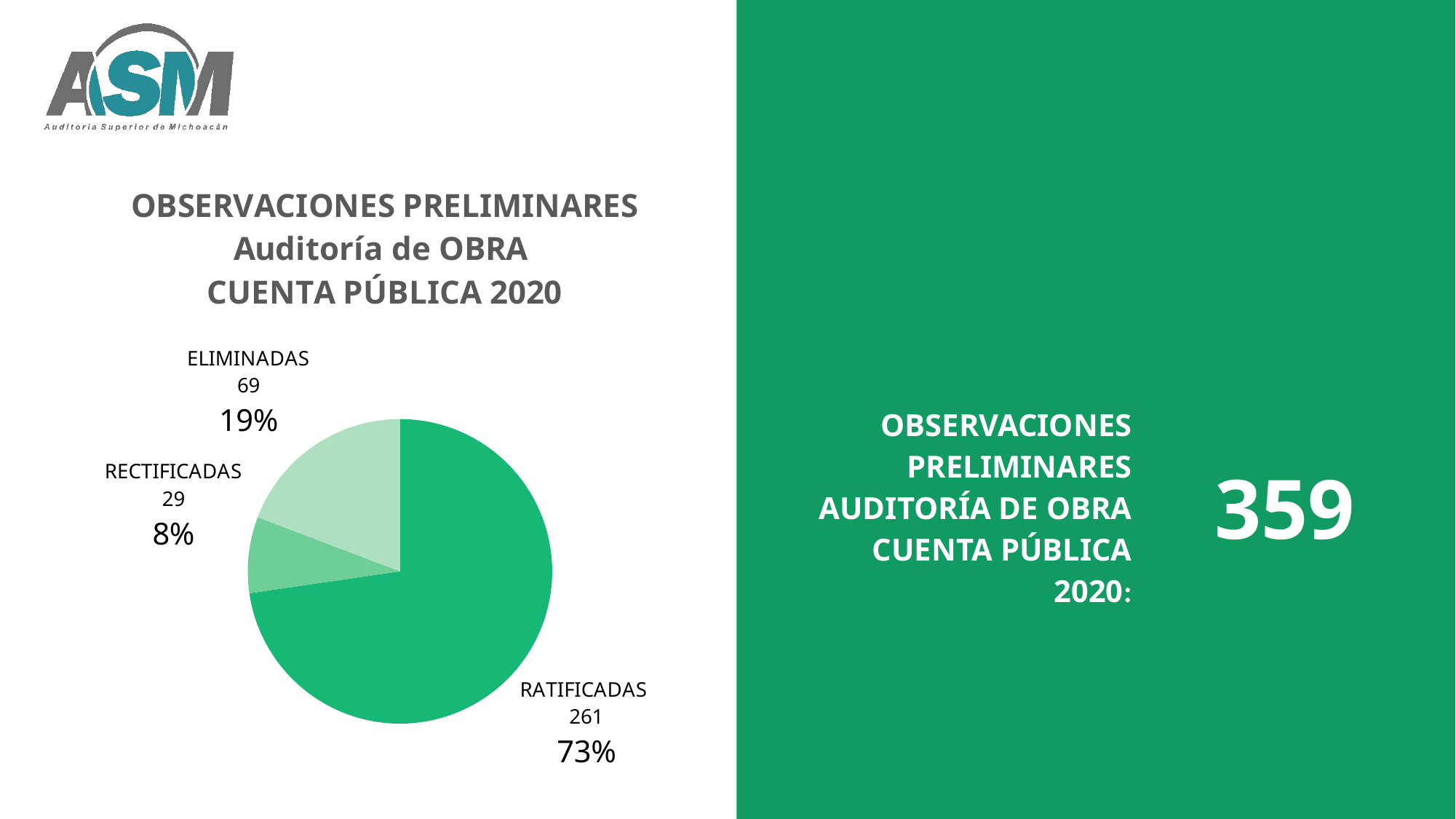
What is the title of the chart? OBSERVACIONES PRELIMINARES Auditoría de OBRA CUENTA PÚBLICA 2020 Which category has the smallest slice? RECTIFICADAS What is the value for ELIMINADAS? 69 What is the difference between the values for RATIFICADAS and ELIMINADAS? 192 What share of the pie does RATIFICADAS represent? 73% How many slices does the pie chart have? 3 What share of the pie does RECTIFICADAS represent? 8% Which category has the largest slice? RATIFICADAS What is the value for RATIFICADAS? 261 What is the value for RECTIFICADAS? 29 What share of the pie does ELIMINADAS represent? 19% What kind of chart is shown on the slide? pie chart